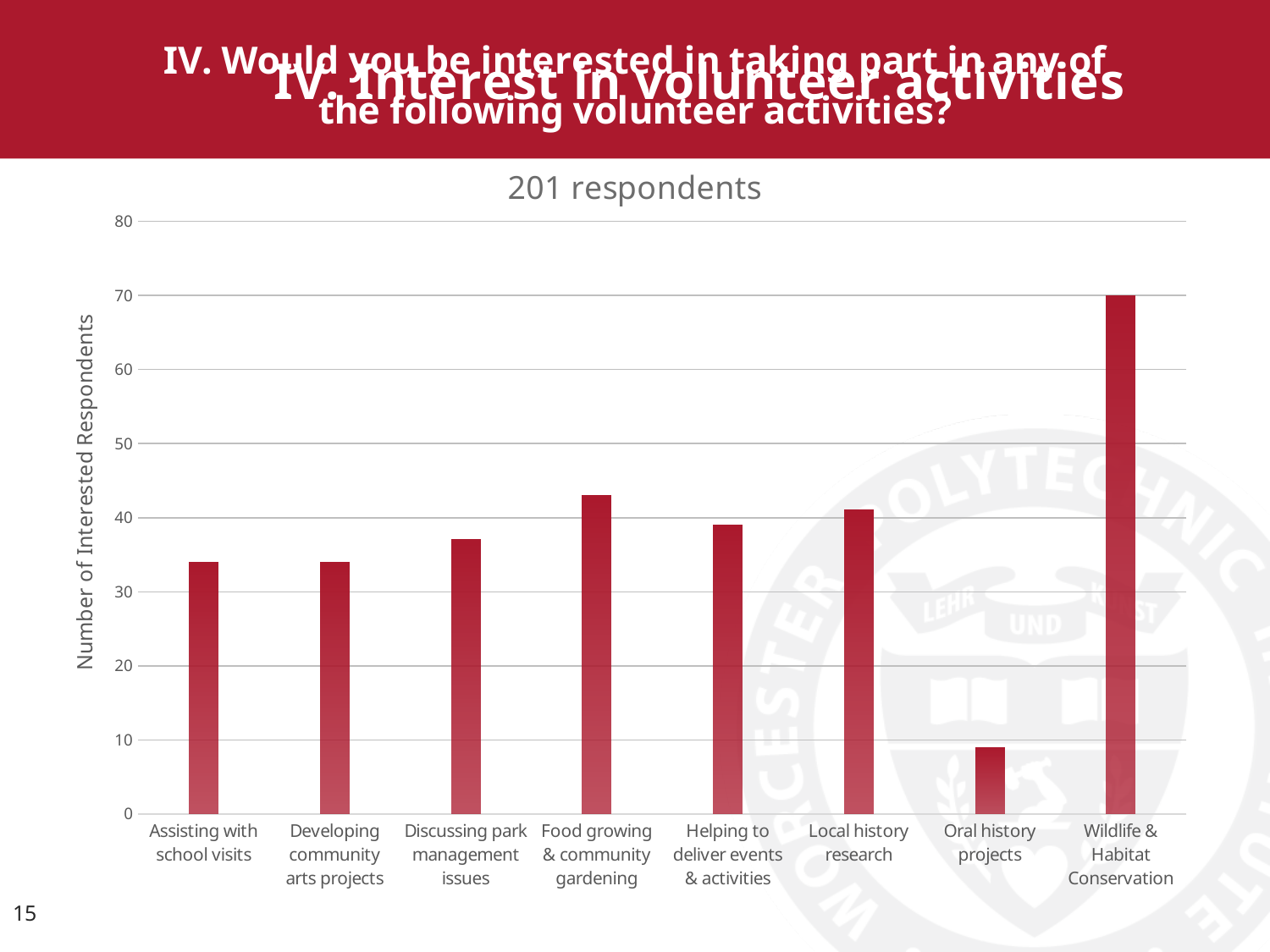
Is the value for Food growing & community gardening greater or less than 40? greater What kind of chart is shown on the slide? bar chart Which has more interested respondents: Food growing & community gardening or Discussing park management issues? Food growing & community gardening Which has more interested respondents: Local history research or Oral history projects? Local history research Is the value for Wildlife & Habitat Conservation greater or less than 60? greater How many volunteer activity categories are shown on the x axis? 8 Which volunteer activity has the lowest number of interested respondents? Oral history projects What is the title shown above the chart? 201 respondents Which volunteer activity has the highest number of interested respondents? Wildlife & Habitat Conservation Is the value for Assisting with school visits greater or less than 40? less What is the label on the vertical axis of the chart? Number of Interested Respondents